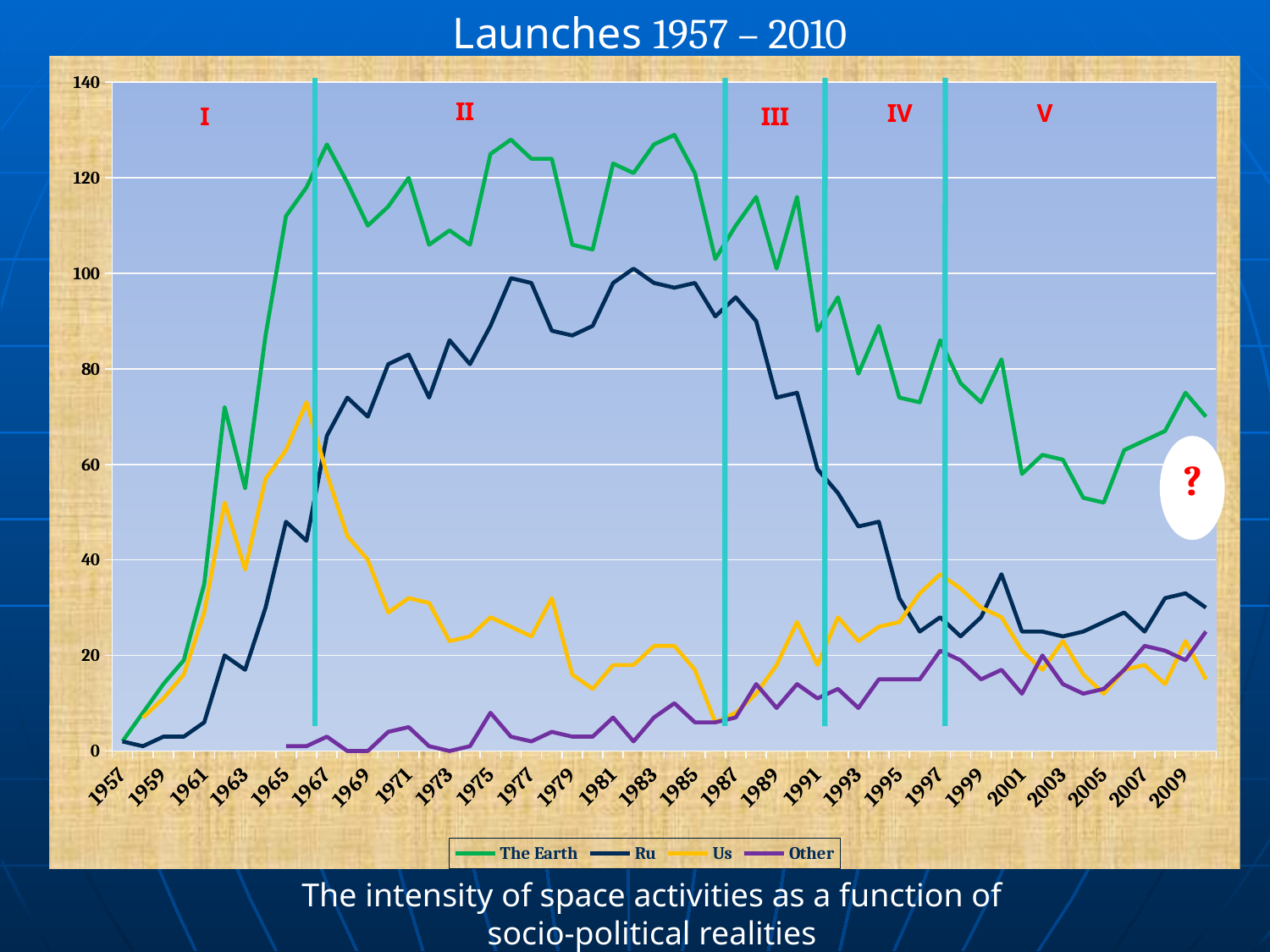
Does the Ru series rise or fall between 1987 and 1993? fall What are the four series named in the legend? The Earth, Ru, Us, Other How many Roman-numeral periods (I, II, III, ...) are marked on the chart? 5 How many series does the legend list? 4 Is the value for The Earth in 2009 greater or less than 60? greater Is the value for Other in 1975 greater or less than 20? less Is the value for The Earth in 1967 greater or less than 120? greater In 1983, which series has the higher value, Ru or Us? Ru In 2009, which series has the higher value, Ru or Us? Ru What kind of chart is shown on the slide? line chart